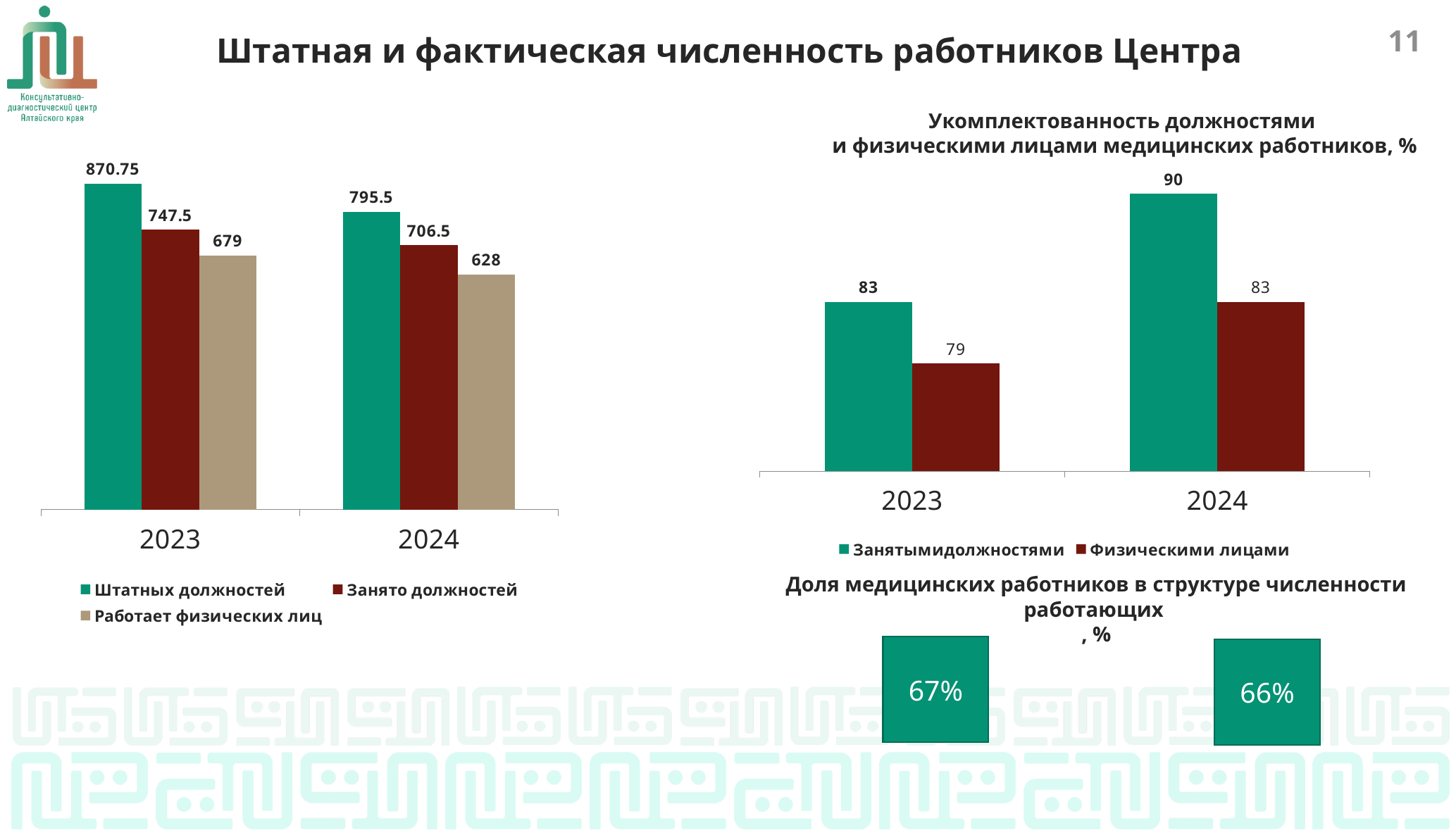
In the chart titled 'Укомплектованность должностями и физическими лицами медицинских работников, %', what is the difference between Занятыми должностями and Физическими лицами in 2024? 7 In the chart titled 'Укомплектованность должностями и физическими лицами медицинских работников, %', which is larger in 2023: Занятыми должностями or Физическими лицами? Занятыми должностями In the left chart, which series has the lowest value in 2023? Работает физических лиц In the left chart, does the value for Штатных должностей rise or fall from 2023 to 2024? fall In the left chart, what is the difference between Штатных должностей and Занято должностей in 2024? 89 What kind of chart is the left chart? bar chart In the chart titled 'Укомплектованность должностями и физическими лицами медицинских работников, %', what is the value for Физическими лицами in 2023? 79 In the chart titled 'Укомплектованность должностями и физическими лицами медицинских работников, %', what is the value for Занятыми должностями in 2024? 90 In the left chart, what is the value for Работает физических лиц in 2024? 628 How many year categories are shown on the x axis of the chart titled 'Укомплектованность должностями и физическими лицами медицинских работников, %'? 2 In the left chart, what is the value for Штатных должностей in 2023? 870.75 How many series does the legend of the left chart list? 3